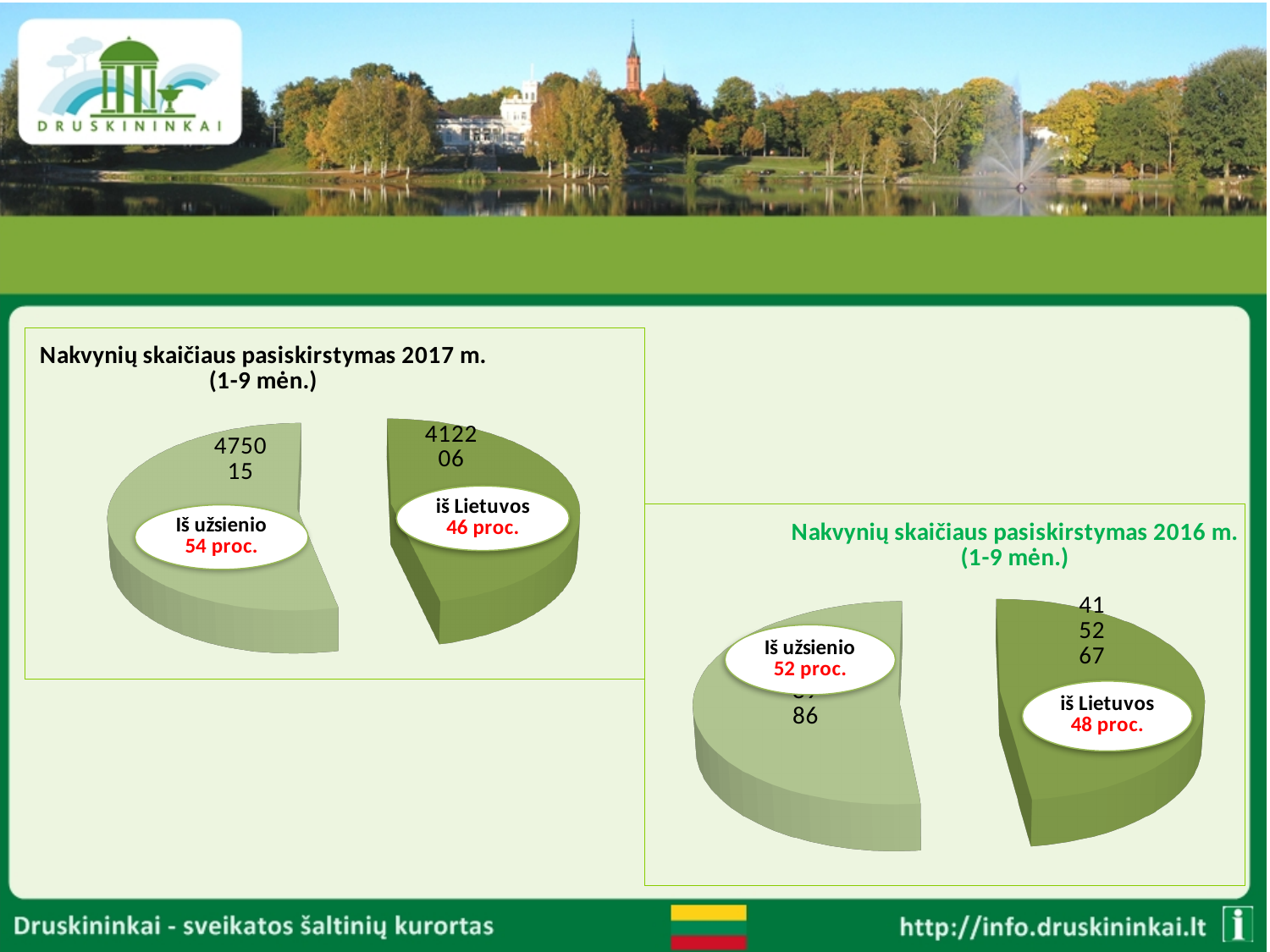
In the 2017 chart on the left, what is the difference in percentage points between 'Iš užsienio' and 'iš Lietuvos'? 8 proc. In the 2016 chart on the right, what is the difference in percentage points between 'Iš užsienio' and 'iš Lietuvos'? 4 proc. What is the title of the chart on the right of the slide? Nakvynių skaičiaus pasiskirstymas 2016 m. (1-9 mėn.) What kind of chart is the 'Nakvynių skaičiaus pasiskirstymas 2017 m. (1-9 mėn.)' chart on the left? pie chart In the 2016 chart on the right, what share of the pie is 'iš Lietuvos'? 48 proc. In the 2017 chart on the left, which slice is the largest? Iš užsienio In the 2017 chart on the left, what share of the pie is 'iš Lietuvos'? 46 proc. In the 2016 chart on the right, which slice is the smallest? iš Lietuvos In the 2016 chart on the right, which is larger: 'Iš užsienio' or 'iš Lietuvos'? Iš užsienio In the 2017 chart on the left, what share of the pie is 'Iš užsienio'? 54 proc. How many slices does the 2017 chart on the left have? 2